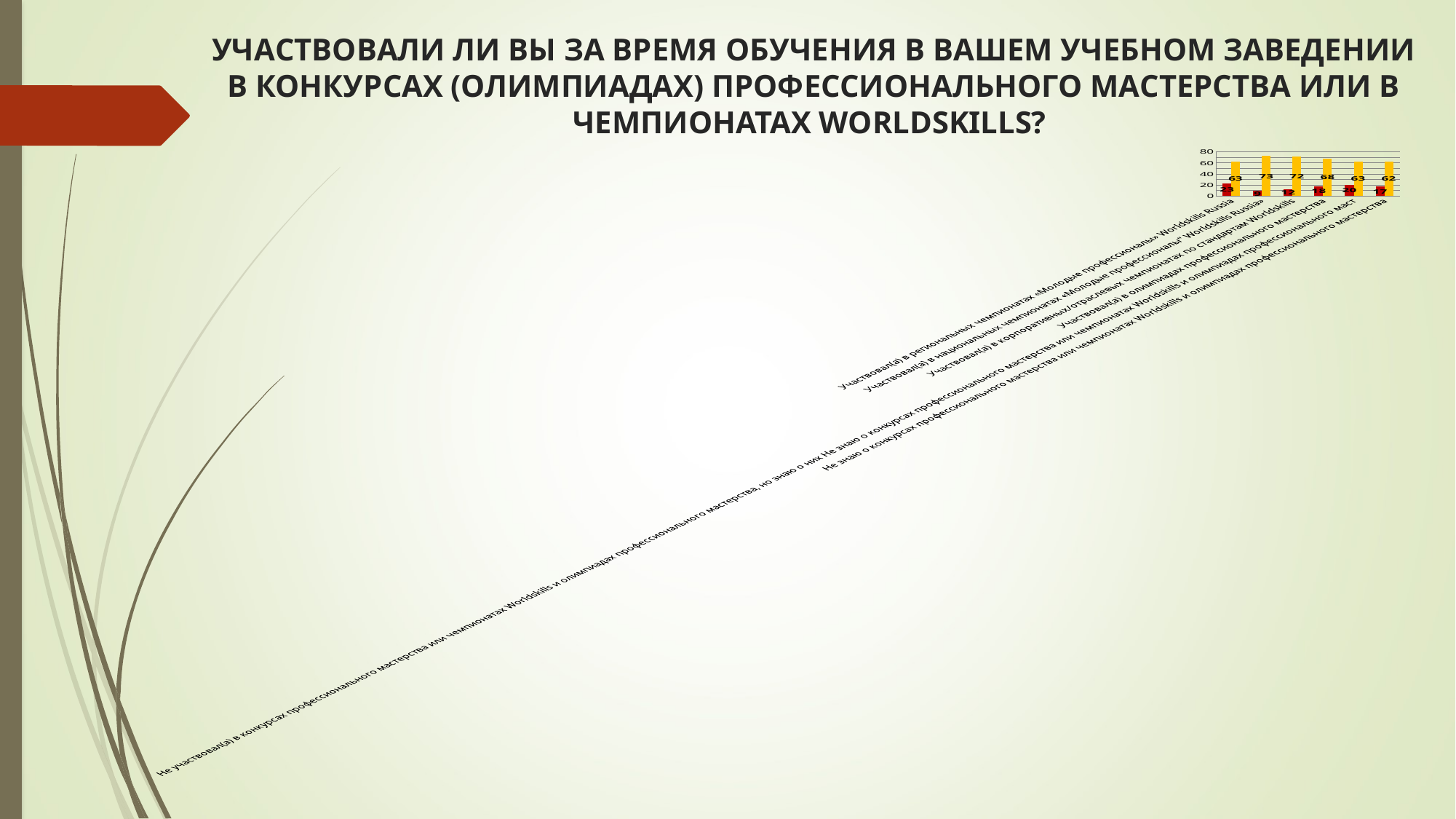
Which category has the lowest yellow bar? the sixth category (62) Is the value of the red bar for the first category greater or less than 40? less What is the value of the yellow bar for the first category? 63 What two colours are used for the bar series in the chart? red and yellow Which is larger: the yellow bar for the second category or the yellow bar for the fourth category? the second category (73) What is the value of the yellow bar for the last (sixth) category? 62 What is the difference between the highest yellow value (73) and the lowest yellow value (62)? 11 How many categories (groups of bars) does the chart show? 6 What is the value of the yellow bar for the second category? 73 Which category has the highest yellow bar? the second category (73) What kind of chart is shown on the slide? bar chart What is the value of the yellow bar for the fourth category? 68